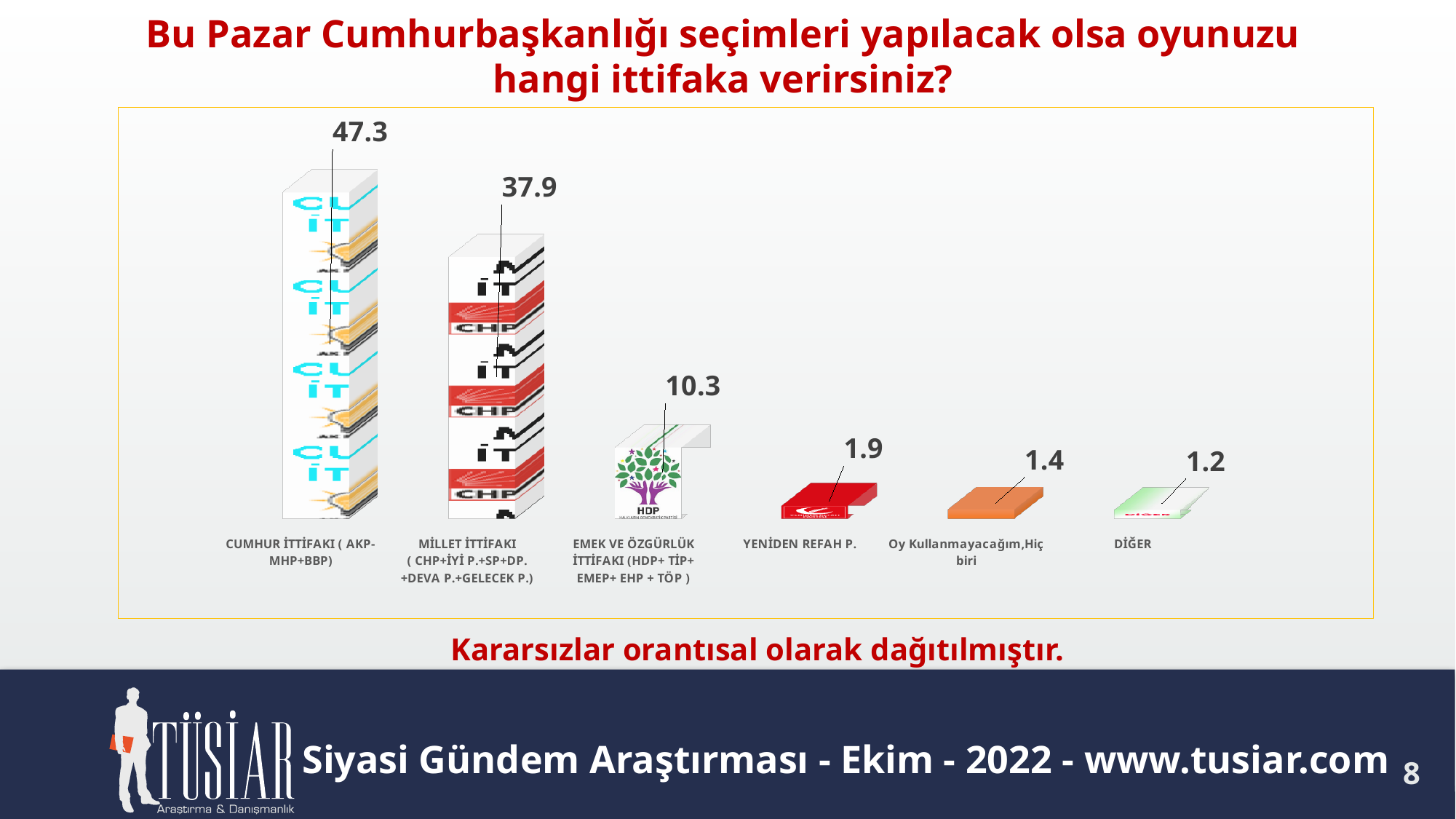
What value is shown for DİĞER? 1.2 Which is larger, the value for YENİDEN REFAH P. or the value for Oy Kullanmayacağım,Hiç biri? YENİDEN REFAH P. What is the difference between the values for CUMHUR İTTİFAKI and MİLLET İTTİFAKI? 9.4 What value is shown for EMEK VE ÖZGÜRLÜK İTTİFAKI? 10.3 What value is shown for CUMHUR İTTİFAKI (AKP-MHP+BBP)? 47.3 What value is shown for MİLLET İTTİFAKI? 37.9 What value is shown for YENİDEN REFAH P.? 1.9 What kind of chart is shown on the slide? Bar chart What is the difference between the values for EMEK VE ÖZGÜRLÜK İTTİFAKI and YENİDEN REFAH P.? 8.4 How many categories are shown in the chart? 6 Which category has the lowest value? DİĞER Which category has the highest value? CUMHUR İTTİFAKI (AKP-MHP+BBP)